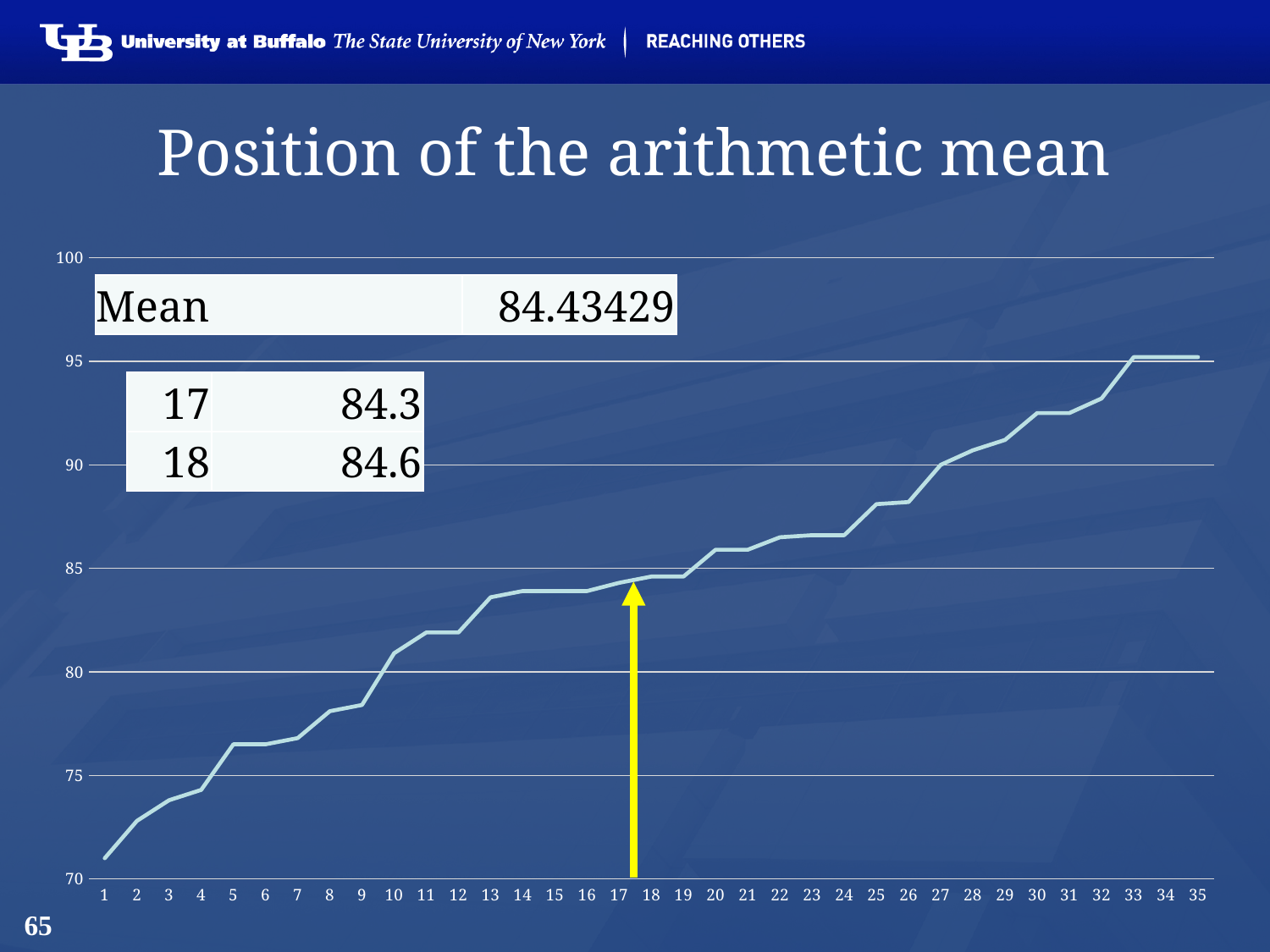
What kind of chart is shown on the slide? line chart Is the value at position 1 greater or less than 75? less What is the difference between the values at positions 18 and 17? 0.3 How many data points are plotted along the x axis? 35 Is the value at position 30 greater or less than 90? greater What is the value at position 18? 84.6 Which is larger, the value at position 17 or the value at position 18? 18 Do the plotted values rise or fall as the x axis goes from 1 to 35? rise What is the value at position 17? 84.3 What is the value of the arithmetic mean shown on the slide? 84.43429 Which position has the lowest value on the chart? 1 What is the title of the chart on the slide? Position of the arithmetic mean